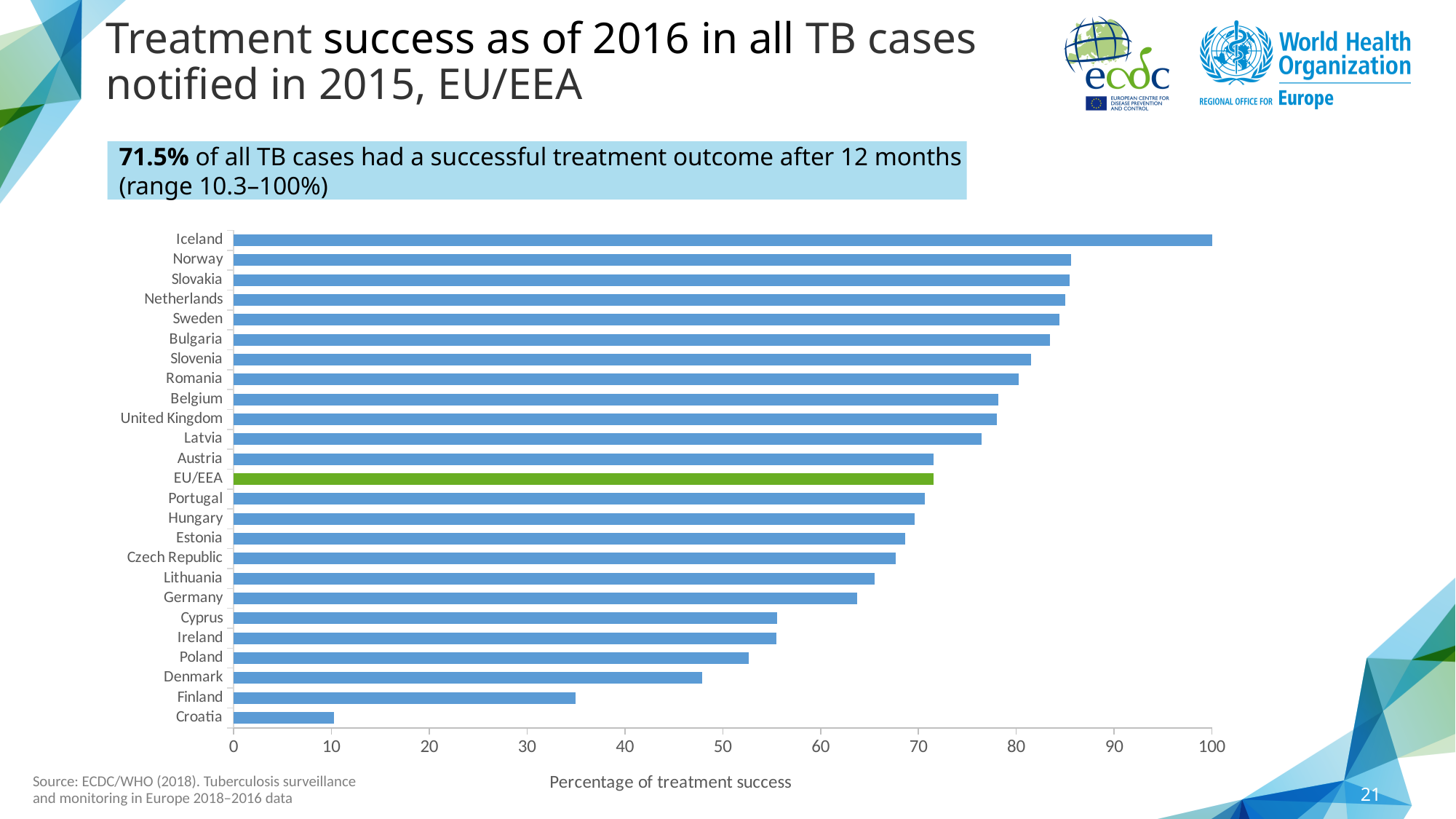
Which country has the highest percentage of treatment success? Iceland What is the treatment success percentage for EU/EEA? 71.5% How many bars (countries plus EU/EEA) are plotted in the chart? 25 What is the treatment success percentage for Iceland? 100% Is the value for Finland greater or less than 40? less Which has a higher treatment success percentage, Denmark or Finland? Denmark Do the bar values rise or fall going from the top of the chart to the bottom? fall What kind of chart is shown on the slide? bar chart What is the label on the horizontal axis of the chart? Percentage of treatment success Is the value for Norway greater or less than 80? greater Is the value for Germany greater or less than 60? greater Which country has the lowest percentage of treatment success? Croatia